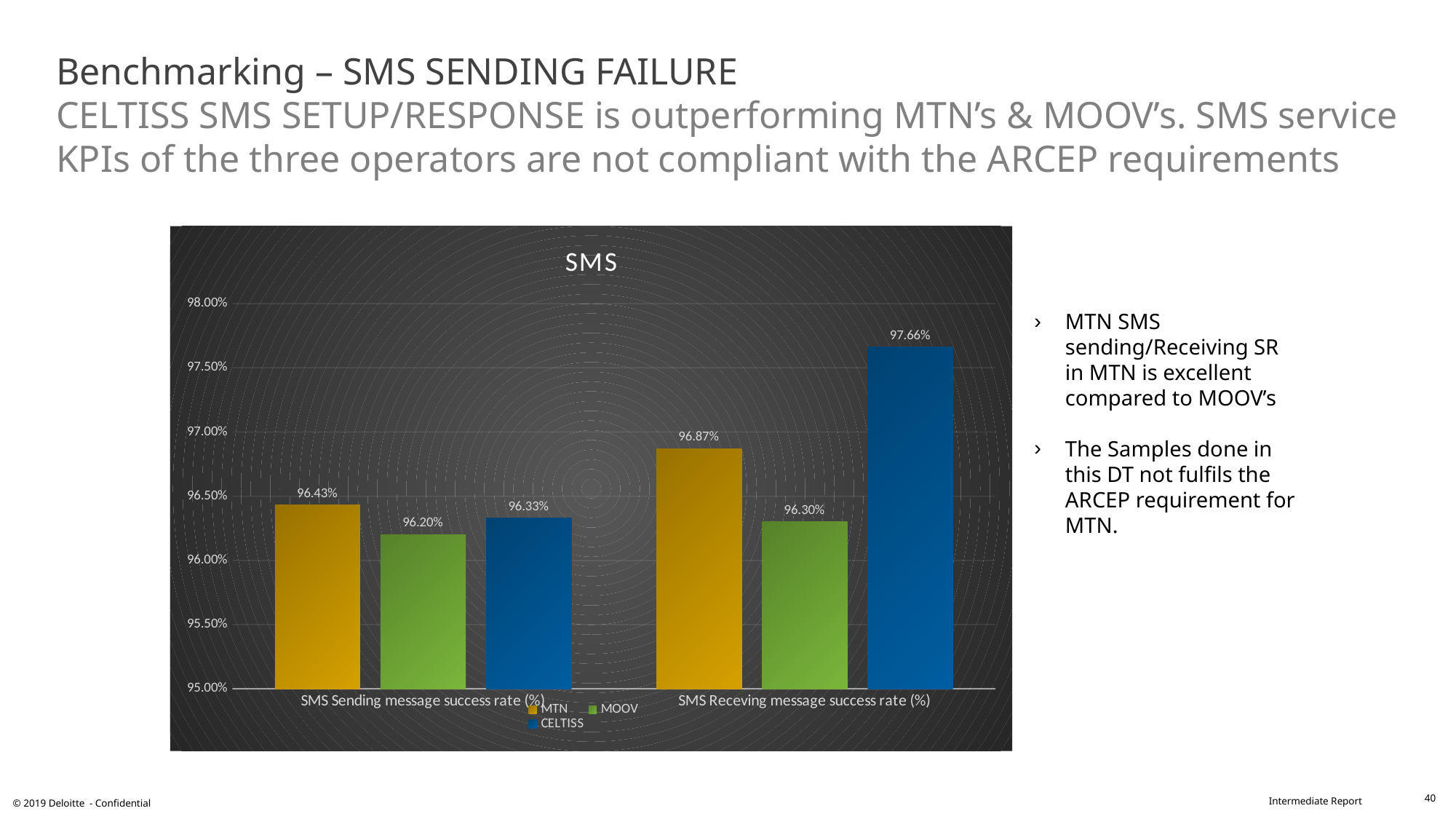
What is the MOOV value for SMS Receving message success rate (%)? 96.30% What is the difference between the CELTISS and MTN values for SMS Receving message success rate (%)? 0.79% What is the difference between the MTN and MOOV values for SMS Sending message success rate (%)? 0.23% What is the CELTISS value for SMS Receving message success rate (%)? 97.66% Is the CELTISS value for SMS Receving message success rate (%) greater or less than 97.50%? greater How many series does the legend list? 3 Which operator has the highest SMS Receving message success rate (%)? CELTISS What is the MTN value for SMS Sending message success rate (%)? 96.43% Which operator has the lowest SMS Sending message success rate (%)? MOOV Which is larger: the MTN value for SMS Sending message success rate (%) or the MTN value for SMS Receving message success rate (%)? SMS Receving message success rate (%) What kind of chart is shown on the slide? Bar chart What is the CELTISS value for SMS Sending message success rate (%)? 96.33%